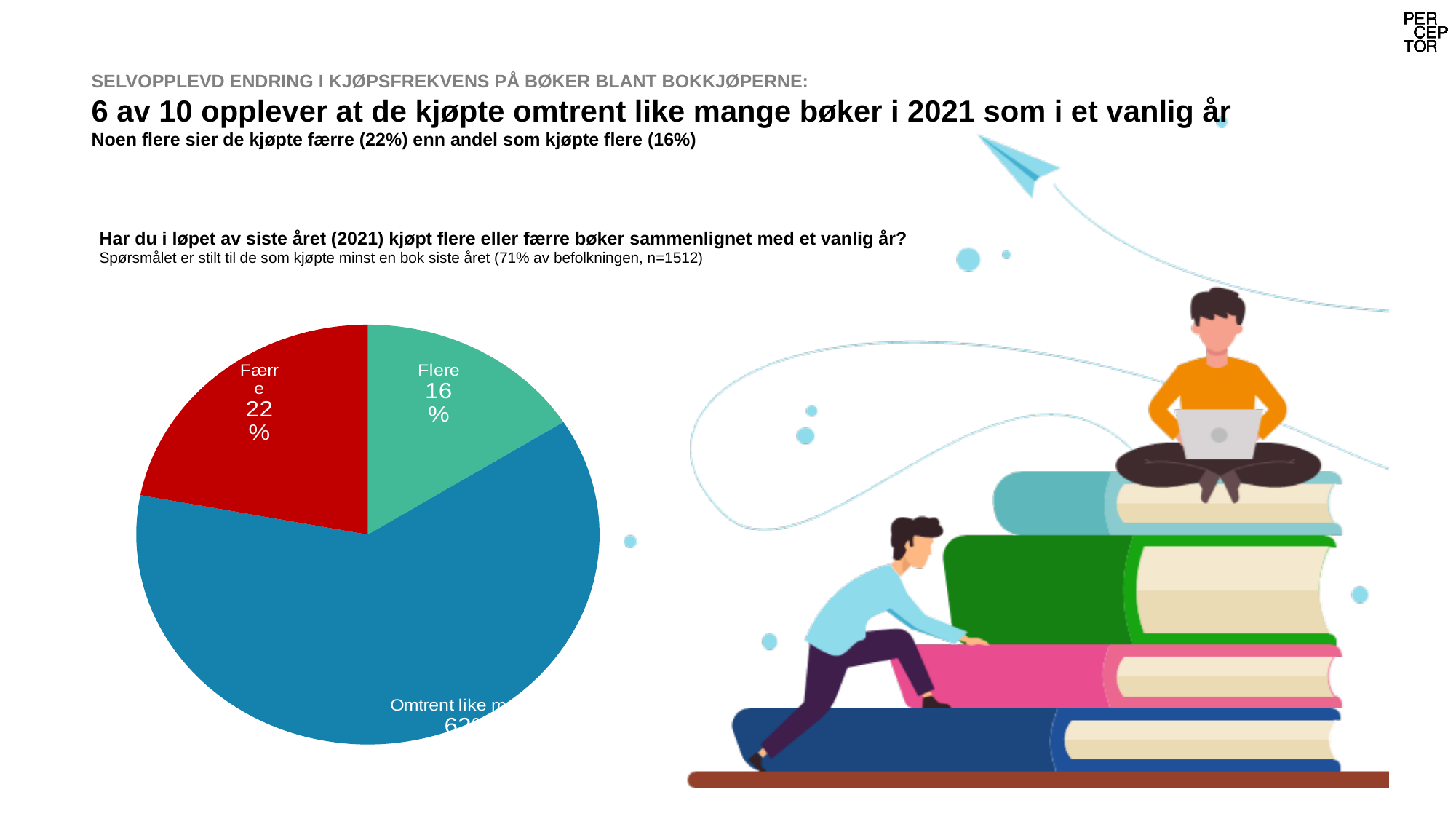
Which is larger, the Færre slice or the Flere slice? Færre Which slice of the pie chart is the largest? Omtrent like mange What share of the pie do the Færre and Flere slices make up together? 38% What type of chart is shown on the slide? Pie chart What percentage of book buyers said they bought more books (Flere) in 2021? 16% What percentage of book buyers said they bought fewer books (Færre) in 2021 compared with a normal year? 22% What colour is the Flere slice in the pie chart? Green How many percentage points larger is the Færre slice than the Flere slice? 6 percentage points Which slice of the pie chart is the smallest? Flere What colour is the Færre slice in the pie chart? Red How many slices does the pie chart have? 3 Is the Færre slice greater or less than 25% of the pie? less